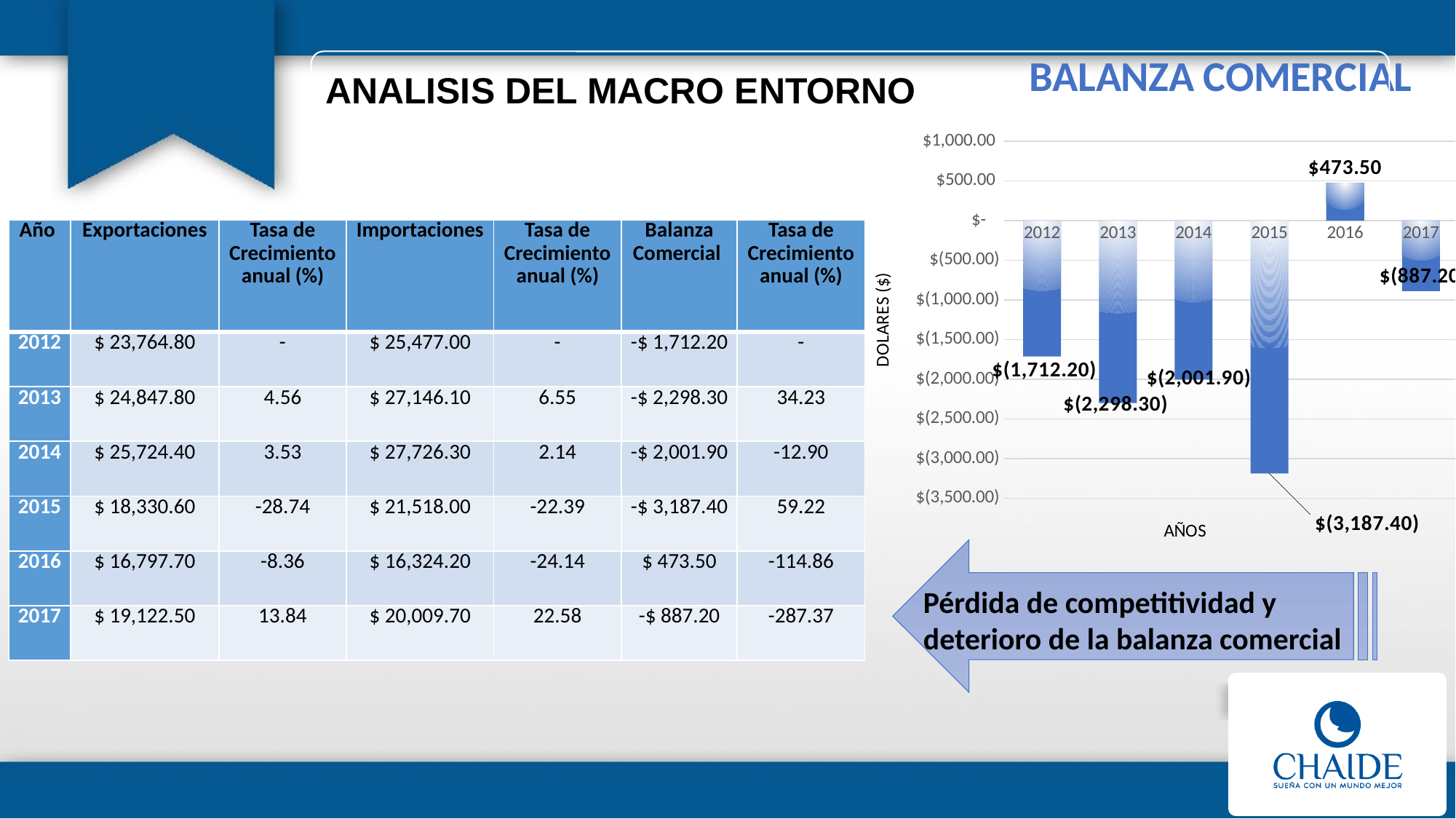
What is the vertical axis title of the BALANZA COMERCIAL chart? DOLARES ($) On the BALANZA COMERCIAL chart, what is the difference between the values for 2012 and 2013? $586.10 On the BALANZA COMERCIAL chart, which year has the larger value, 2013 or 2014? 2014 Which year has the highest value on the BALANZA COMERCIAL chart? 2016 On the BALANZA COMERCIAL chart, does the value rise or fall from 2015 to 2016? rise What kind of chart is the BALANZA COMERCIAL chart? bar chart How many years are plotted on the BALANZA COMERCIAL chart? 6 What is the value for 2016 on the BALANZA COMERCIAL chart? $473.50 What is the value for 2015 on the BALANZA COMERCIAL chart? $(3,187.40) On the BALANZA COMERCIAL chart, is the value for 2017 greater or less than $(500.00)? less Which year has the lowest value on the BALANZA COMERCIAL chart? 2015 What is the value for 2012 on the BALANZA COMERCIAL chart? $(1,712.20)